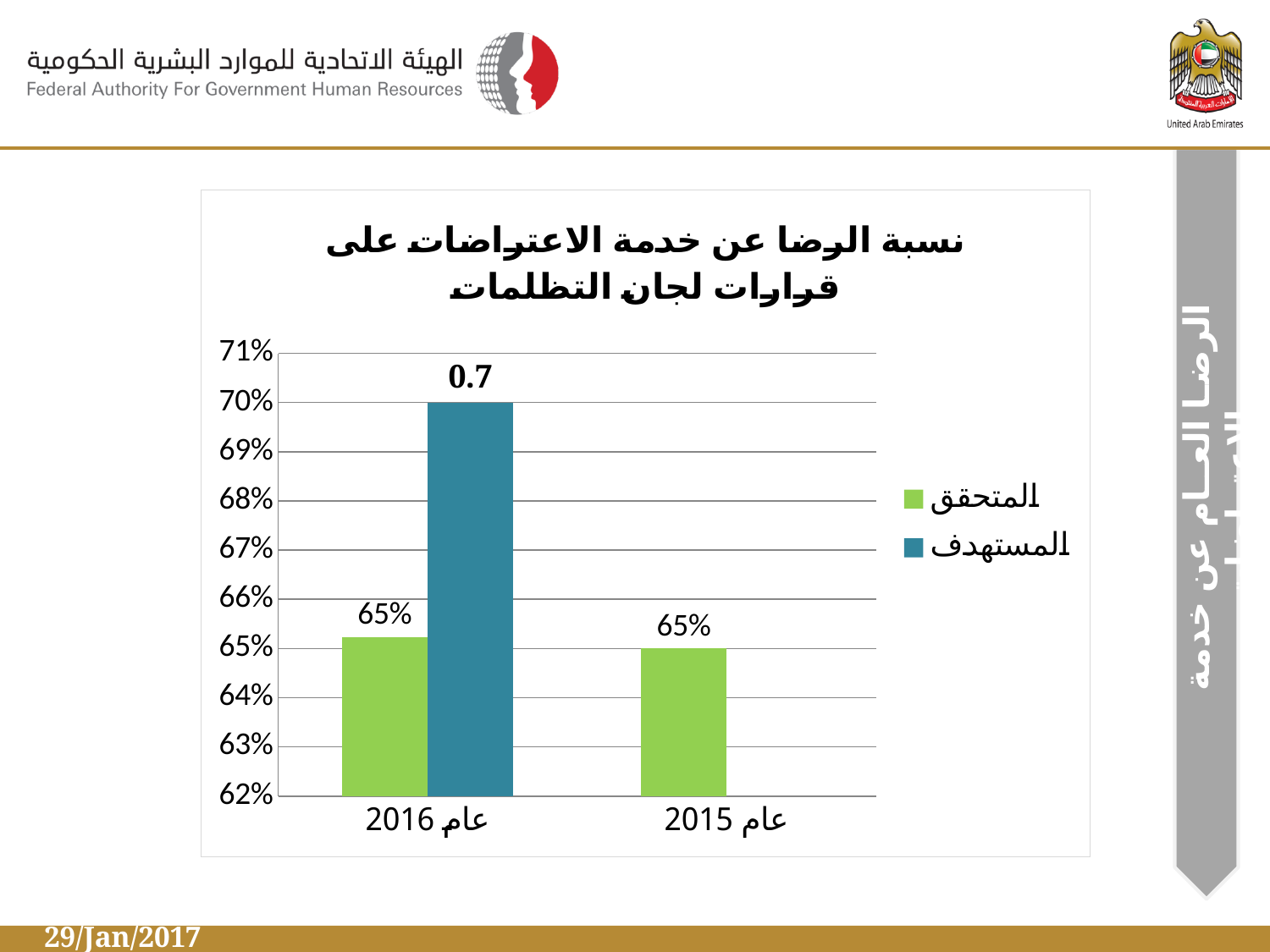
Is the value of المستهدف for عام 2016 greater or less than 68%? greater What is the value of المتحقق for عام 2016? 65% How many categories are shown on the x axis? 2 What kind of chart is shown on the slide? Bar chart For عام 2016, which is larger: المتحقق or المستهدف? المستهدف What data label is shown on the المستهدف bar for عام 2016? 0.7 How many series does the legend list? 2 Is the value of المتحقق for عام 2015 greater or less than 67%? less Which category has a bar for المستهدف? عام 2016 What is the value of المتحقق for عام 2015? 65% What colour represents المتحقق in the legend? Green